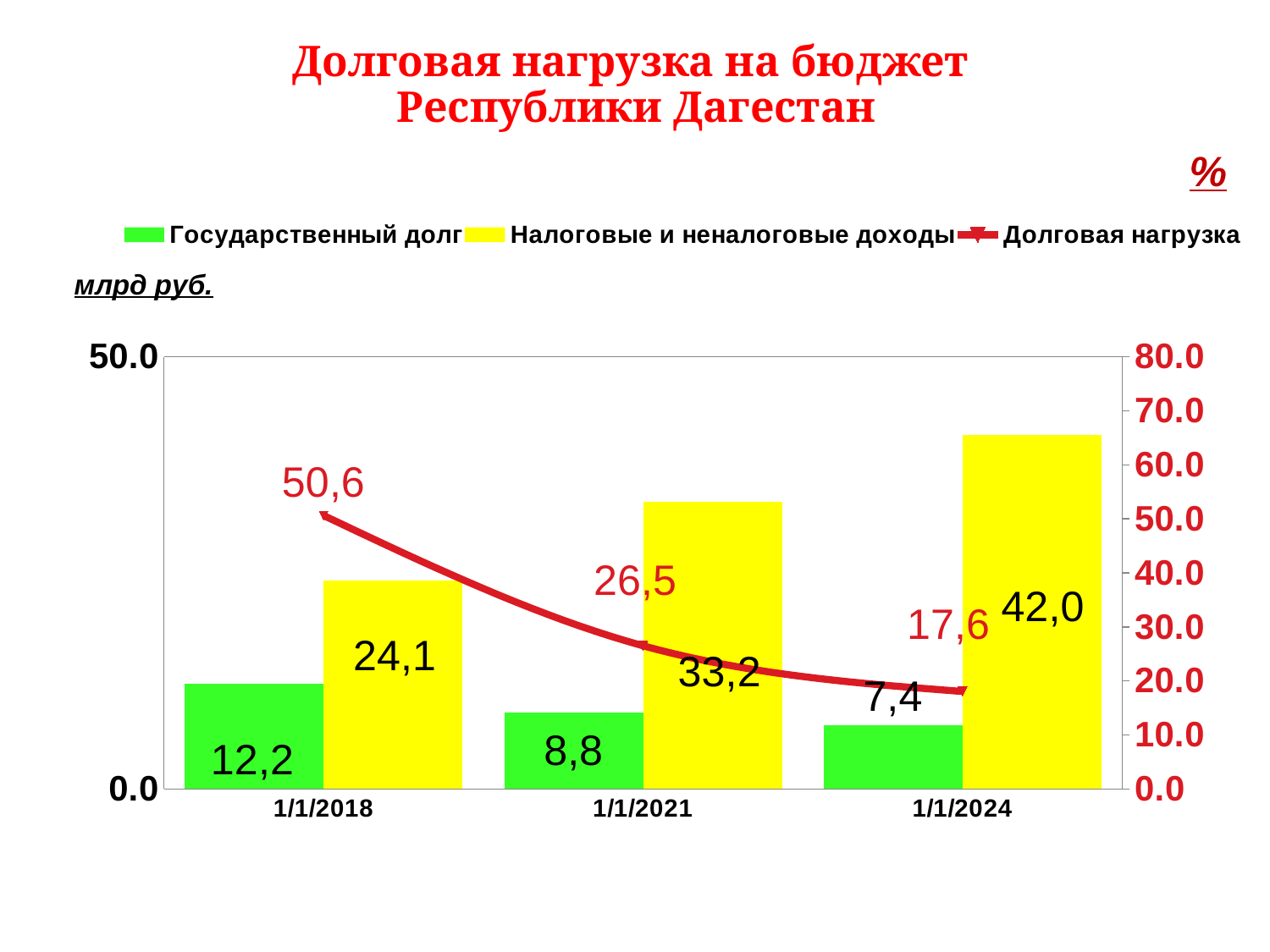
What is the value of Долговая нагрузка for 1/1/2021? 26,5 What is the value of Налоговые и неналоговые доходы for 1/1/2024? 42,0 In which year is Государственный долг the lowest? 1/1/2024 How many series does the legend list? 3 What is the value of Государственный долг for 1/1/2018? 12,2 Does Долговая нагрузка rise or fall from 1/1/2018 to 1/1/2024? Fall What kind of chart is this? Combined bar and line chart In which year is Налоговые и неналоговые доходы the highest? 1/1/2024 What colour are the bars for Налоговые и неналоговые доходы? Yellow Which is larger: Государственный долг for 1/1/2018 or for 1/1/2021? 1/1/2018 How many dates are shown on the x axis? 3 What is the difference between Налоговые и неналоговые доходы for 1/1/2024 and 1/1/2018? 17,9